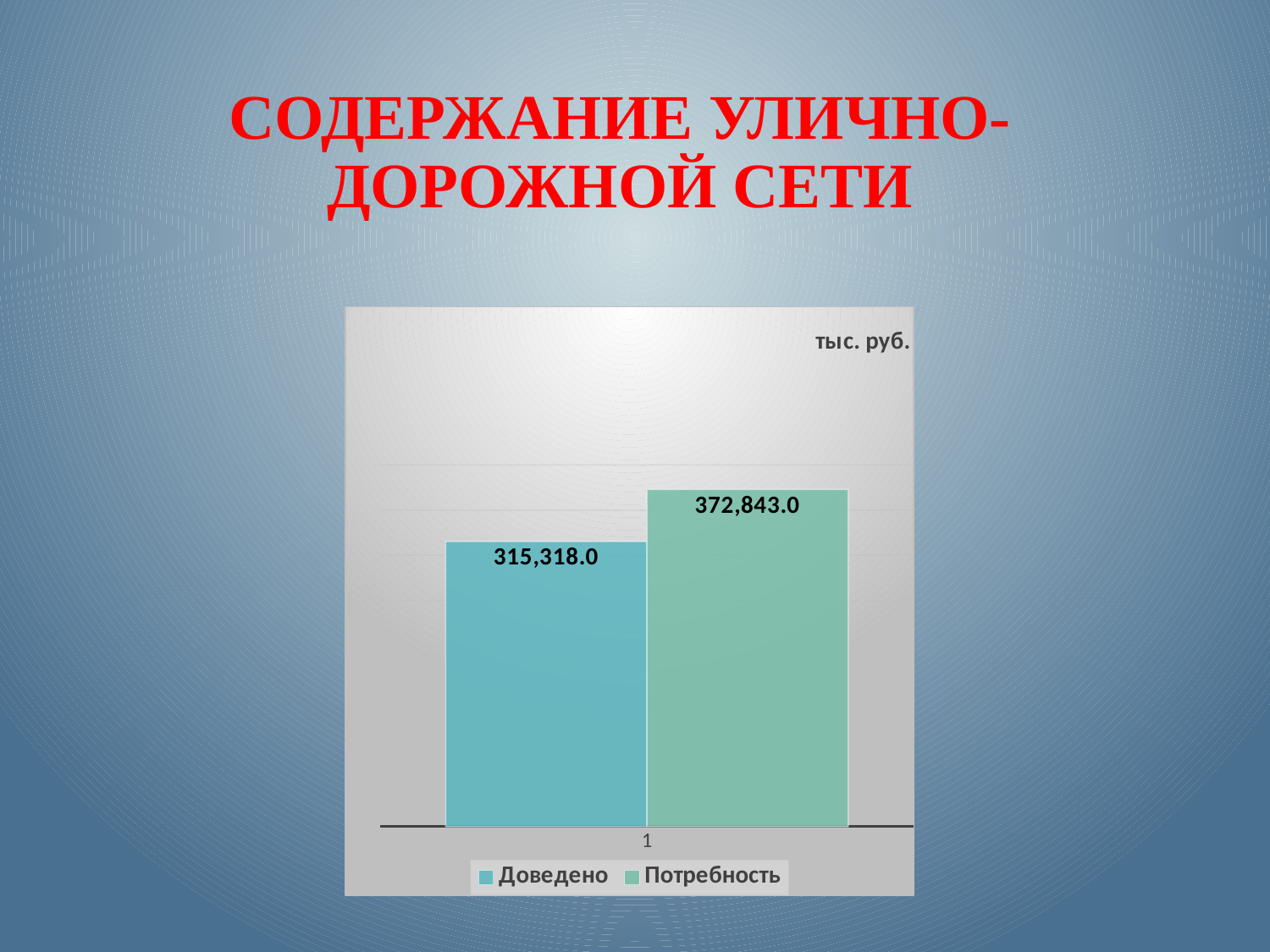
What kind of chart is shown on the slide? bar chart What is the difference between the Потребность value and the Доведено value? 57,525.0 How many bars are plotted on the chart? 2 Which series has the lower value? Доведено What is the value for Доведено? 315,318.0 What is the value for Потребность? 372,843.0 What unit is shown in the top right corner of the chart? тыс. руб. How many series does the legend list? 2 Which series has the higher value, Доведено or Потребность? Потребность What is the title of the slide? СОДЕРЖАНИЕ УЛИЧНО-ДОРОЖНОЙ СЕТИ Is the value for Доведено larger or smaller than the value for Потребность? smaller